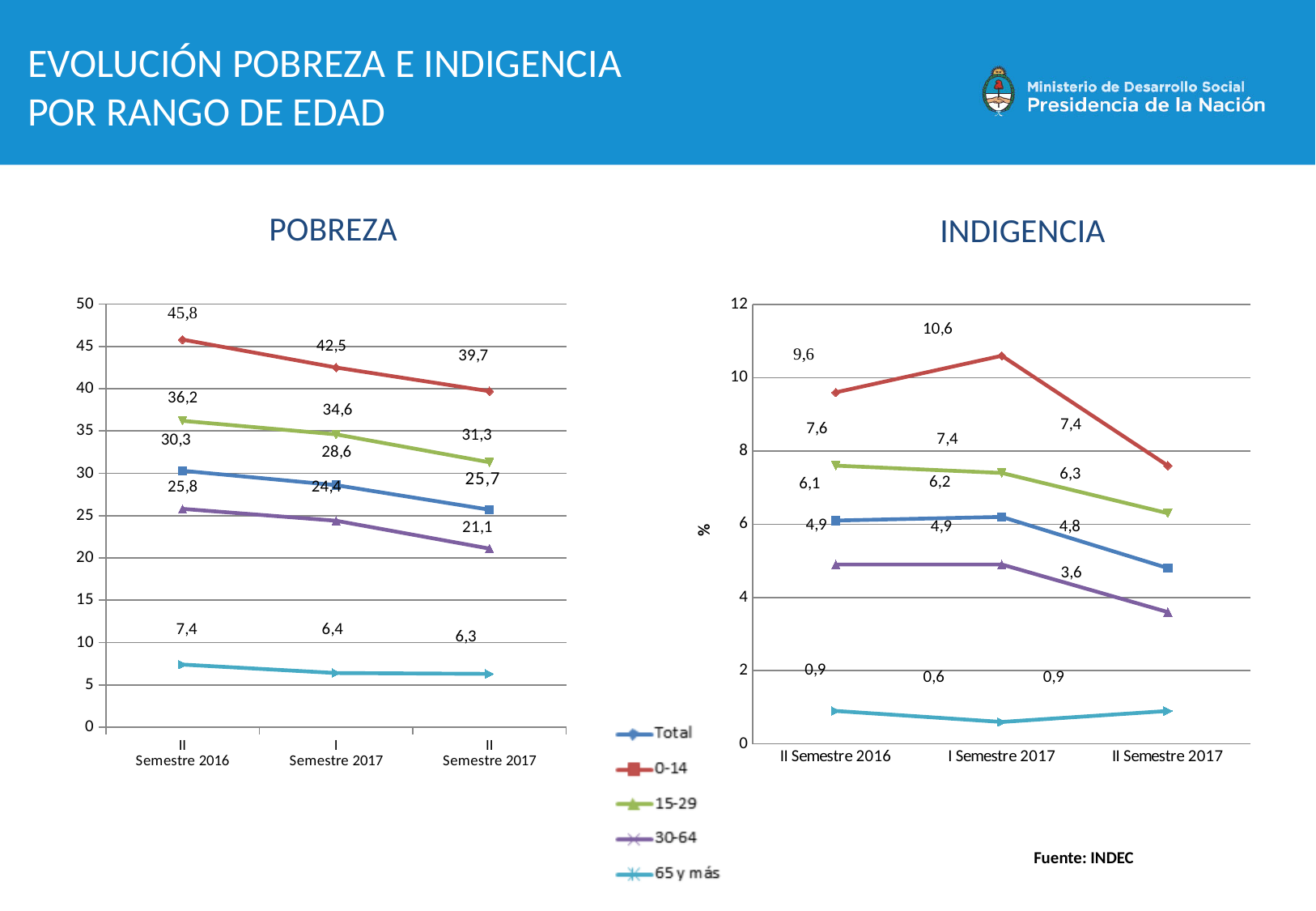
How many series does the legend list? 5 In the POBREZA chart, what is the value for the 65 y más series in II Semestre 2017? 6,3 How many time periods are shown on the x axis of the POBREZA chart? 3 What kind of chart is the INDIGENCIA chart? line chart In the INDIGENCIA chart, which series has the lowest value in I Semestre 2017? 65 y más In the POBREZA chart, what is the value for the 0-14 series in II Semestre 2016? 45,8 In the POBREZA chart, which series has the highest value in II Semestre 2017? 0-14 In the INDIGENCIA chart, which is larger: the 15-29 value in II Semestre 2016 or the Total value in II Semestre 2016? 15-29 In the INDIGENCIA chart, what is the value for the 30-64 series in II Semestre 2017? 3,6 In the POBREZA chart, what is the difference between the 0-14 value in II Semestre 2016 and its value in II Semestre 2017? 6,1 In the INDIGENCIA chart, what is the value for the 0-14 series in I Semestre 2017? 10,6 In the POBREZA chart, does the 0-14 series rise or fall from II Semestre 2016 to II Semestre 2017? fall